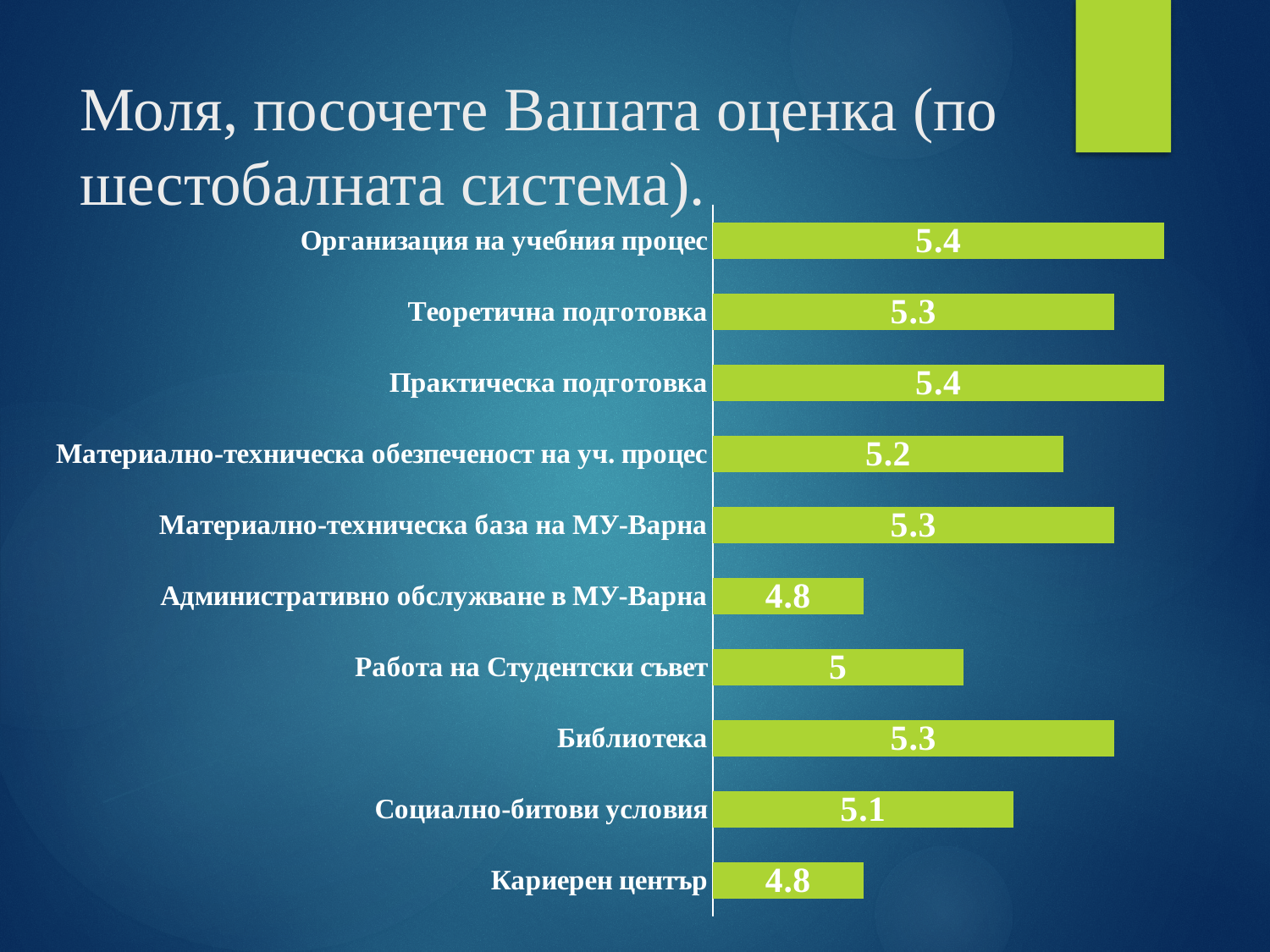
What is the value for Социално-битови условия? 5.1 What is the difference between the values for Теоретична подготовка and Кариерен център? 0.5 What kind of chart is shown on the slide? Bar chart How many categories are shown in the chart? 10 Which has a larger value, Работа на Студентски съвет or Практическа подготовка? Практическа подготовка What is the value for Административно обслужване в МУ-Варна? 4.8 What is the value for Материално-техническа обезпеченост на уч. процес? 5.2 Which has a larger value, Библиотека or Социално-битови условия? Библиотека What is the value for Работа на Студентски съвет? 5 What is the highest value shown in the chart? 5.4 What is the value for Организация на учебния процес? 5.4 What is the lowest value shown in the chart? 4.8